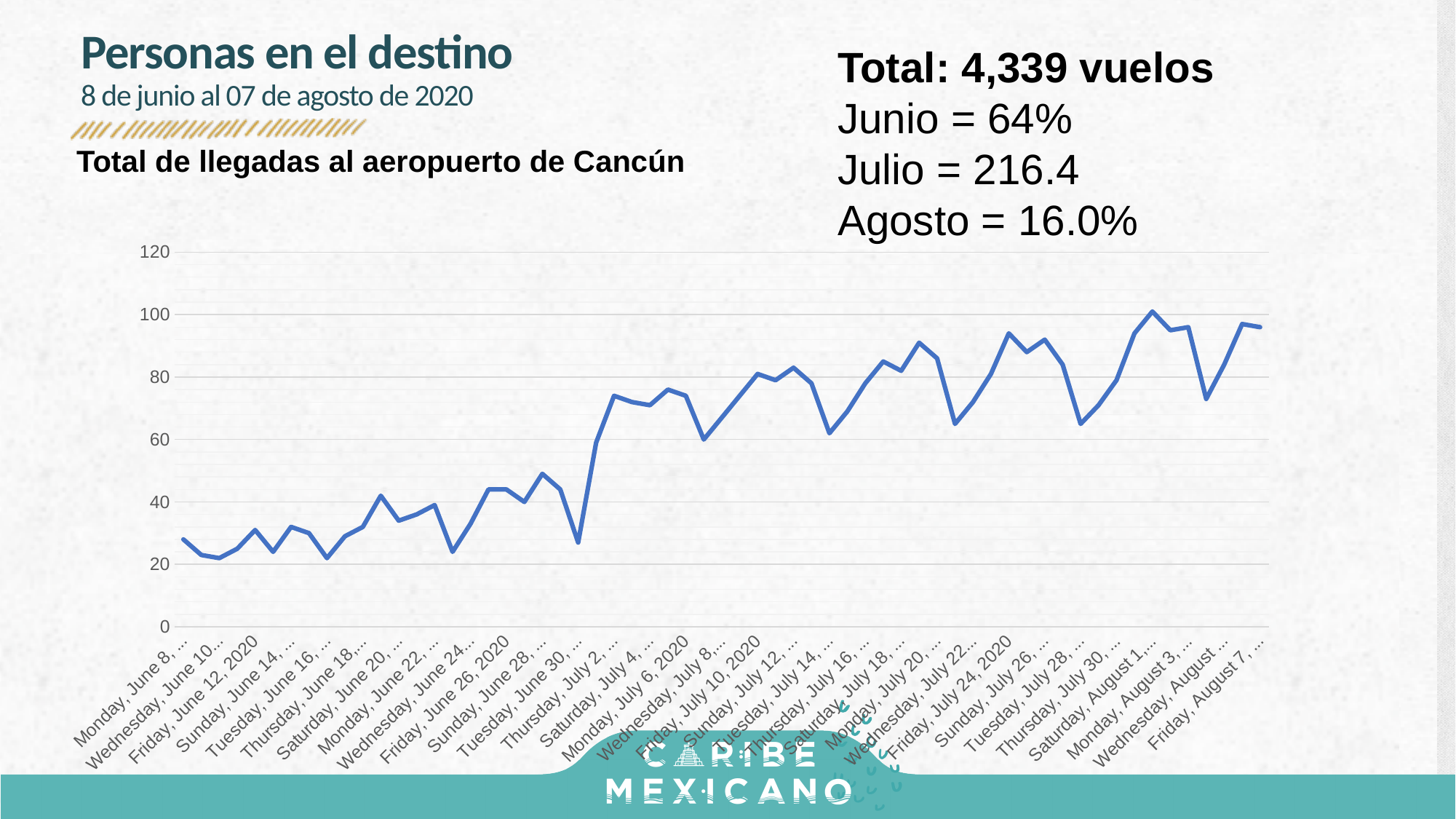
Is the value for Thursday, July 2 greater or less than 60? greater Is the value for Tuesday, June 30 greater or less than 40? less Is the value for Tuesday, July 28 greater or less than 80? less Which has the larger value, Monday, June 8 or Friday, August 7? Friday, August 7 What kind of chart is shown on the slide? line chart What is the highest value shown on the vertical axis of the chart? 120 Overall, do the values rise or fall from Monday, June 8 to Friday, August 7? rise What is the title of the chart? Total de llegadas al aeropuerto de Cancún Which has the larger value, Tuesday, June 30 or Thursday, July 2? Thursday, July 2